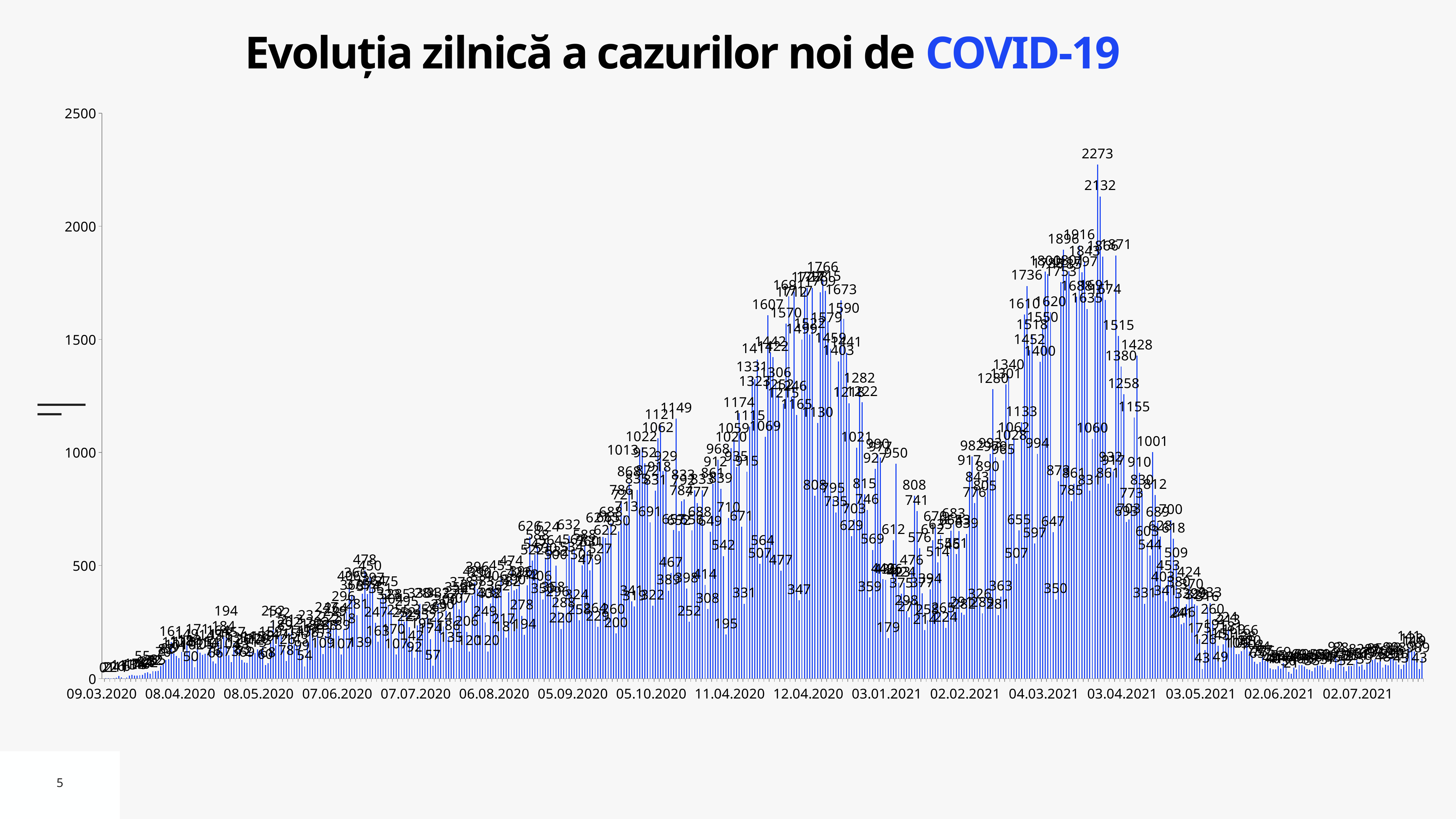
Which is larger, the bar labeled 2273 or the bar labeled 2132? 2273 Is the highest value on the chart greater or less than 2000? greater Is the value at 09.03.2020 greater or less than 500? less What is the difference between the two highest labeled values, 2273 and 2132? 141 What is the title of the chart? Evoluția zilnică a cazurilor noi de COVID-19 What is the first date shown on the horizontal axis? 09.03.2020 What is the highest daily value labeled on the chart? 2273 Between 03.04.2021 and 02.06.2021, do the values generally rise or fall? fall Between 09.03.2020 and 08.04.2020, do the values generally rise or fall? rise Is the value at 02.06.2021 greater or less than 500? less What kind of chart is shown on the slide? bar chart What is the highest tick value shown on the vertical axis? 2500